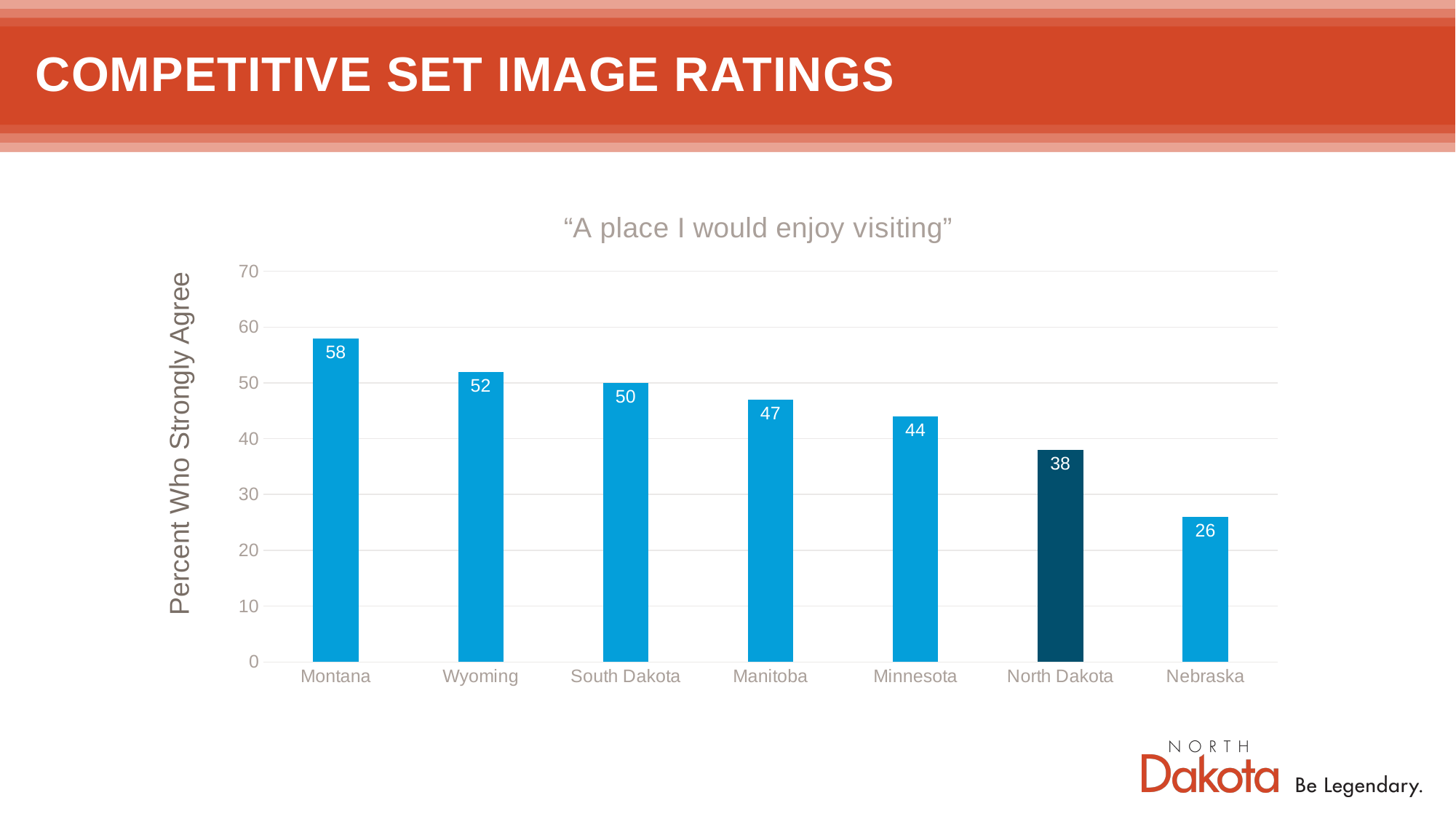
What is the title of the chart? "A place I would enjoy visiting" Is the value for Minnesota greater or less than 40? greater What is the value for North Dakota? 38 Which state or province has the lowest value? Nebraska What is the value for Nebraska? 26 What is the value for Montana? 58 Which state or province has the highest value? Montana Which has a larger value, Wyoming or Manitoba? Wyoming What is the difference between the values for Montana and North Dakota? 20 What kind of chart is shown on the slide? bar chart How many states or provinces are shown on the chart? 7 Do the values rise or fall from left to right along the x axis? fall